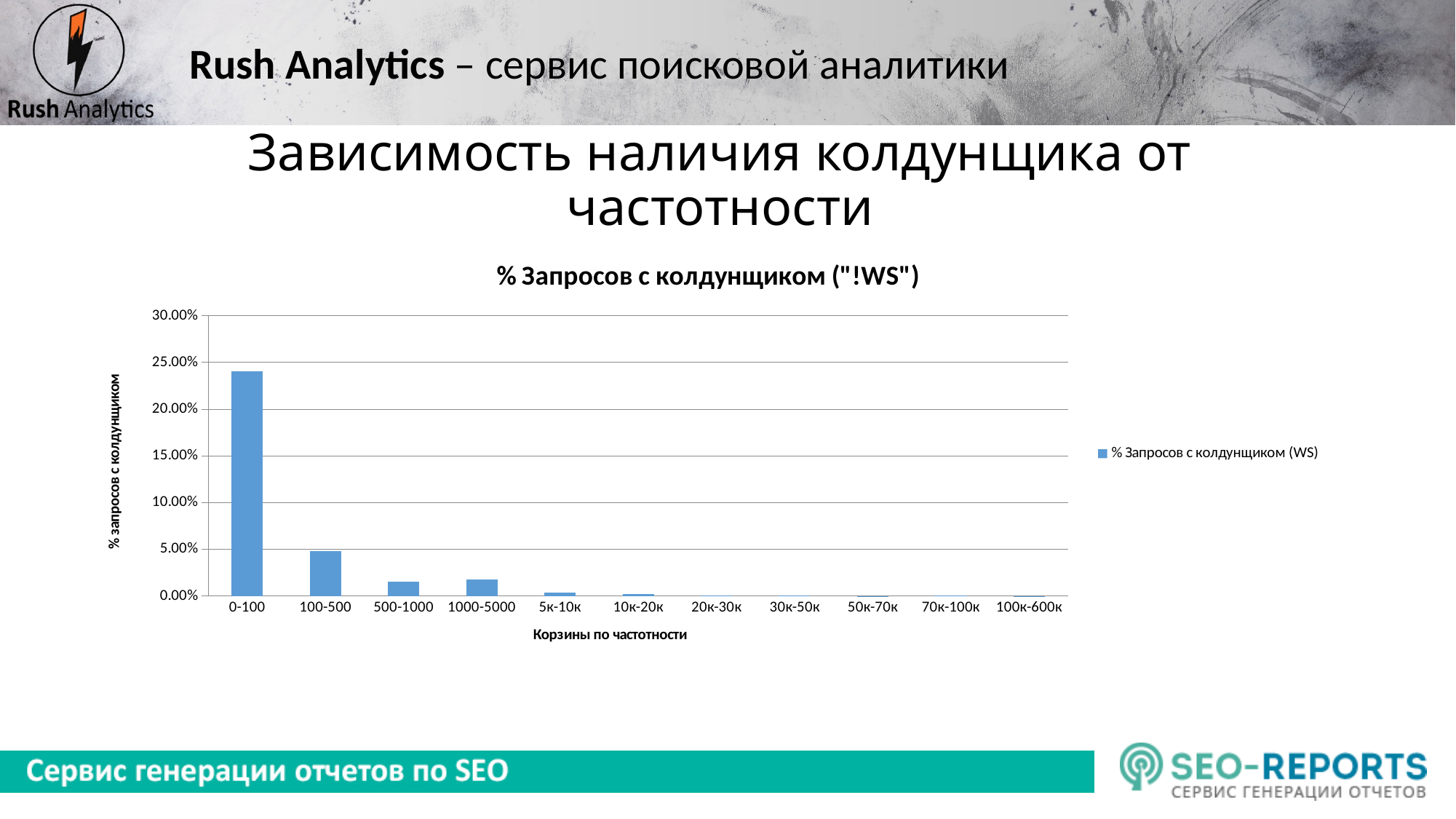
How many series does the chart's legend list? 1 What kind of chart is shown on the slide? Bar chart What is the title of the chart? % Запросов с колдунщиком ("!WS") How many frequency bins (categories) are shown on the x axis of the chart? 11 Which bin has a larger value: 0-100 or 100-500? 0-100 Is the value for the 1000-5000 bin greater or less than 5.00%? less Which frequency bin has the highest share of queries with a колдунщик? 0-100 Do the values generally rise or fall as the frequency bins increase along the x axis? Fall Is the value for the 0-100 bin greater or less than 20.00%? greater Which bin has a larger value: 100-500 or 500-1000? 100-500 Is the value for the 0-100 bin greater or less than 25.00%? less